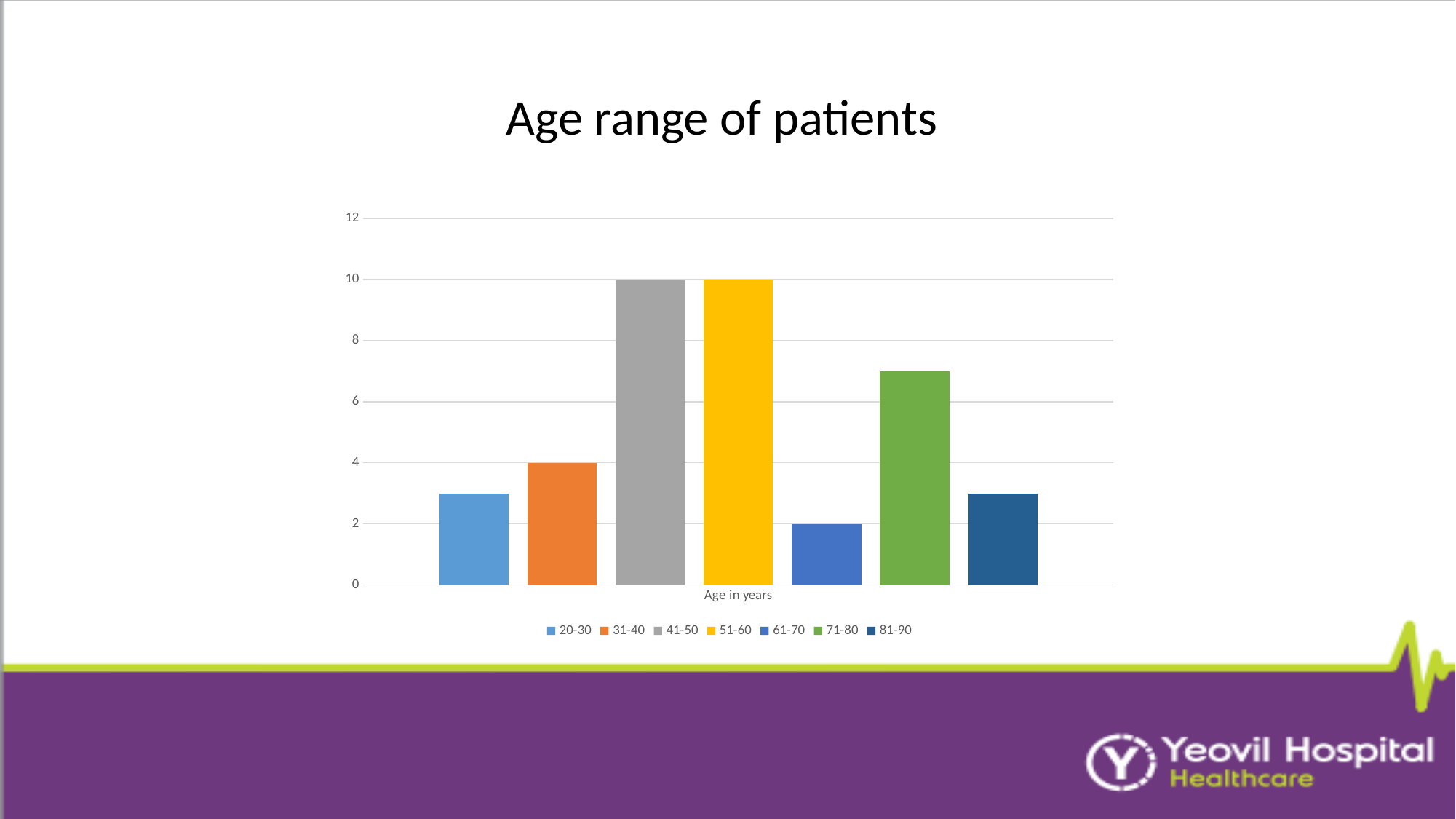
What is the value for the 41-50 age group? 10 What is the difference between the values for the 41-50 and 31-40 age groups? 6 What is the value for the 51-60 age group? 10 Which is larger, the value for 71-80 or the value for 81-90? 71-80 Is the value for the 20-30 age group greater or less than 4? less What is the title of the chart? Age range of patients Is the value for the 71-80 age group greater or less than 6? greater What is the value for the 61-70 age group? 2 How many age groups are plotted in the chart? 7 What is the value for the 31-40 age group? 4 What type of chart is shown on the slide? Bar chart Which age group has the lowest value? 61-70